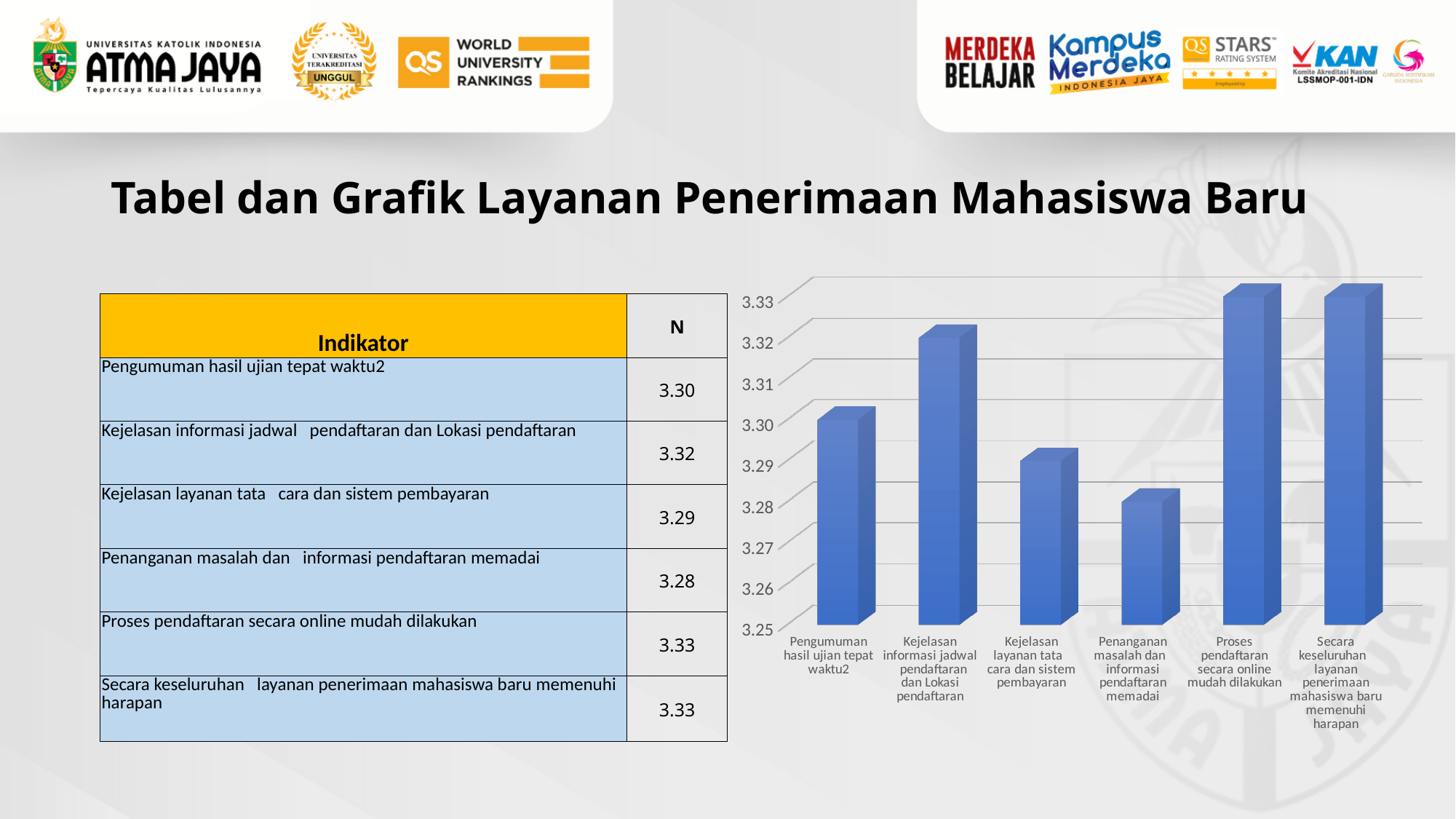
Which indicator has the lowest value in the chart? Penanganan masalah dan informasi pendaftaran memadai What is the value for 'Pengumuman hasil ujian tepat waktu2'? 3.30 Is the value for 'Proses pendaftaran secara online mudah dilakukan' greater or less than 3.30? greater What is the value for 'Penanganan masalah dan informasi pendaftaran memadai'? 3.28 Is the value for 'Penanganan masalah dan informasi pendaftaran memadai' greater or less than 3.30? less What is the lowest value shown on the chart's vertical axis? 3.25 Which is larger: the value for 'Kejelasan informasi jadwal pendaftaran dan Lokasi pendaftaran' or the value for 'Kejelasan layanan tata cara dan sistem pembayaran'? Kejelasan informasi jadwal pendaftaran dan Lokasi pendaftaran What is the value for 'Kejelasan informasi jadwal pendaftaran dan Lokasi pendaftaran'? 3.32 What is the difference between the values for 'Proses pendaftaran secara online mudah dilakukan' and 'Kejelasan layanan tata cara dan sistem pembayaran'? 0.04 What is the title of the slide containing the table and chart? Tabel dan Grafik Layanan Penerimaan Mahasiswa Baru How many categories (indicators) are plotted in the bar chart? 6 What type of chart is shown on the slide? bar chart